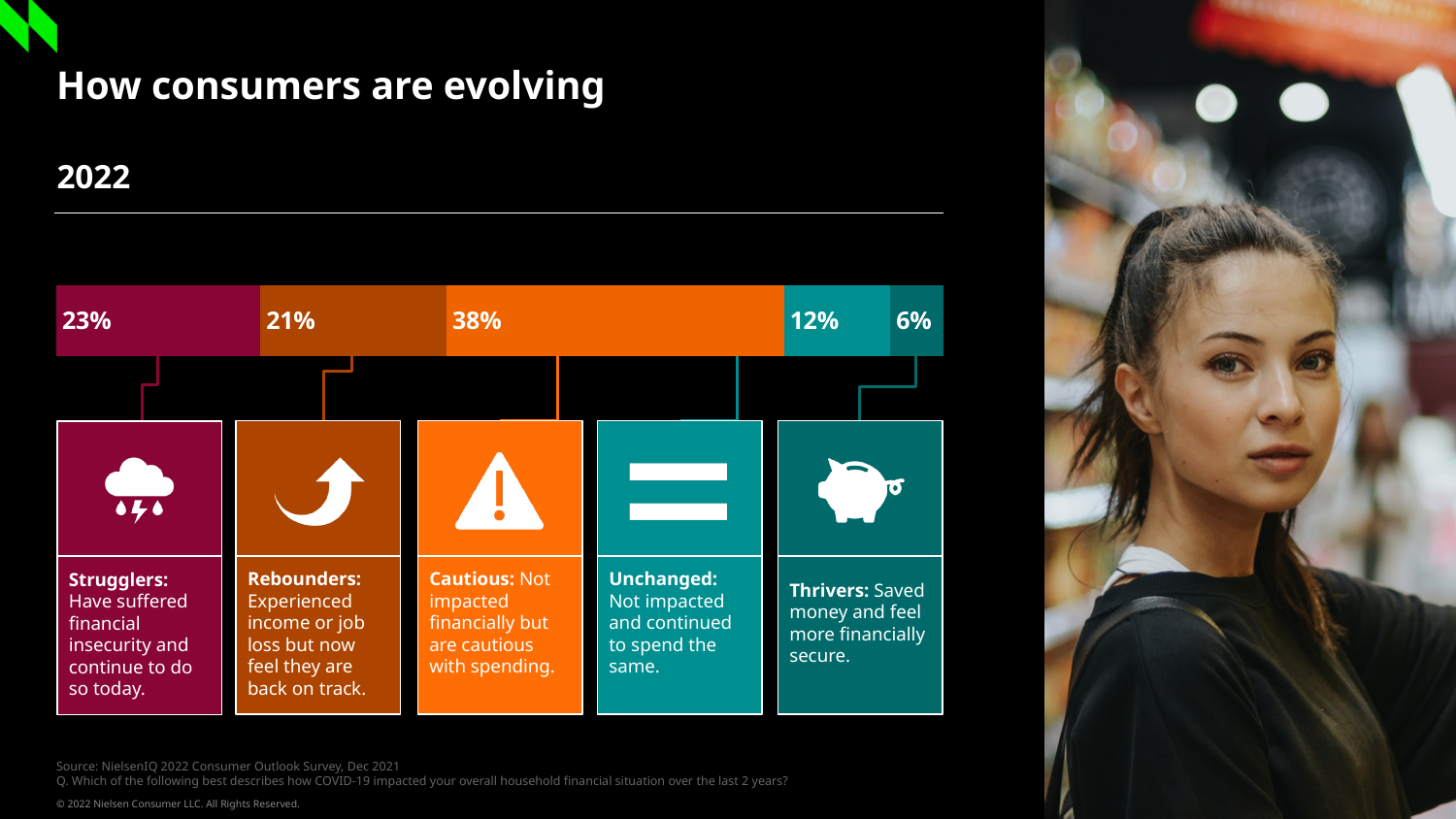
What percentage of consumers are Cautious? 38% What percentage of consumers are Strugglers? 23% Which consumer segment has the largest share? Cautious What percentage of consumers are Unchanged? 12% What percentage of consumers are Rebounders? 21% What kind of chart is used to show the consumer segments? Stacked bar chart What percentage of consumers are Thrivers? 6% Which consumer segment has the smallest share? Thrivers Which segment is larger, Strugglers or Rebounders? Strugglers What is the combined percentage of the Unchanged and Thrivers segments? 18% What is the difference in percentage points between the Cautious and Strugglers segments? 15 How many consumer segments are shown in the bar? 5